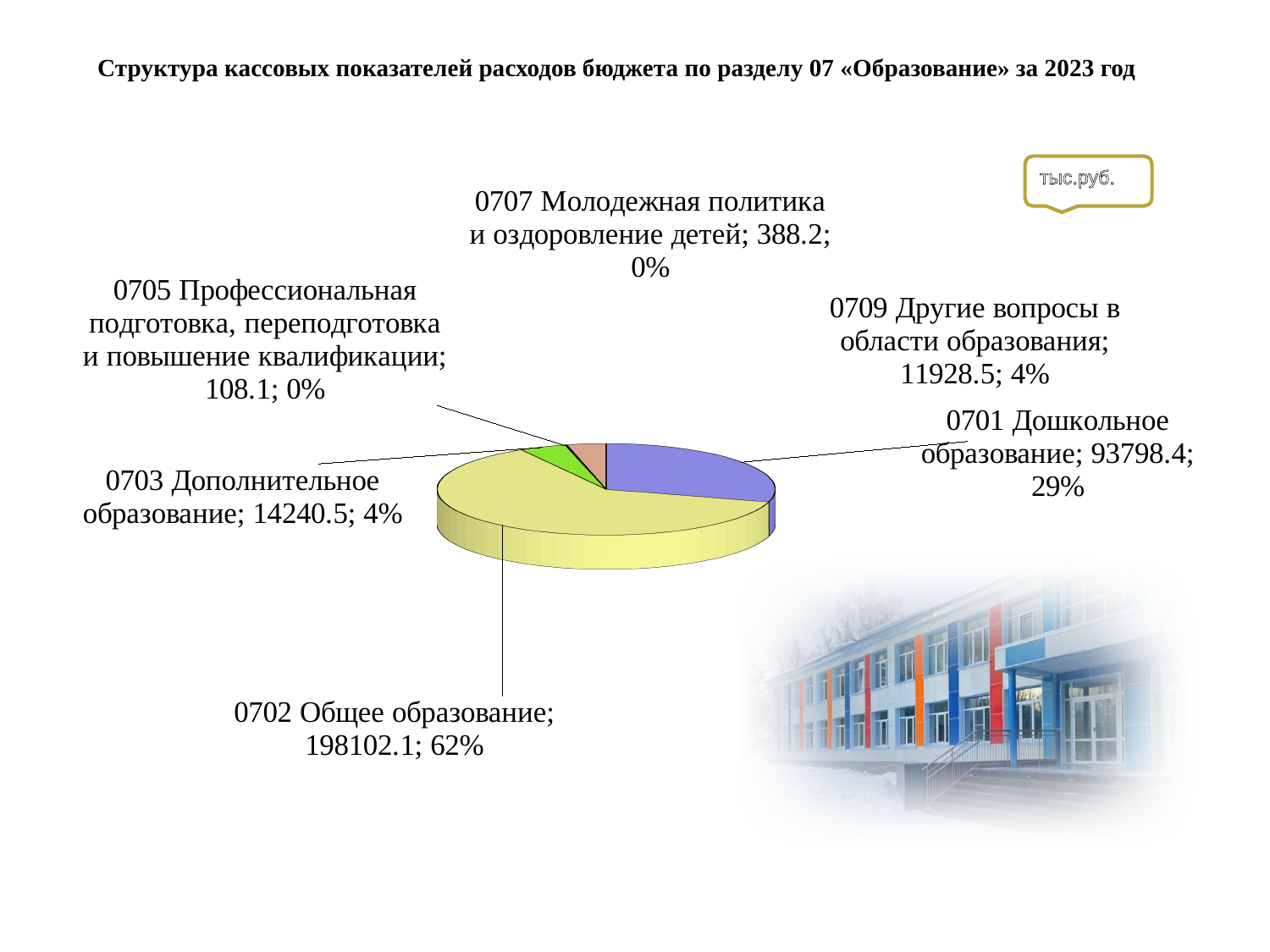
What is the value for 0707 Молодежная политика и оздоровление детей? 388.2 Which category has the largest value? 0702 Общее образование Which is larger, the value for 0703 Дополнительное образование or 0709 Другие вопросы в области образования? 0703 Дополнительное образование What kind of chart is shown on the slide? Pie chart How many categories are shown in the chart? 6 What is the difference between the values for 0702 Общее образование and 0701 Дошкольное образование? 104303.7 What is the value for 0701 Дошкольное образование? 93798.4 Which category has the smallest value? 0705 Профессиональная подготовка, переподготовка и повышение квалификации What is the value for 0702 Общее образование? 198102.1 What share of the pie does 0702 Общее образование represent? 62% What share of the pie does 0701 Дошкольное образование represent? 29% What is the value for 0709 Другие вопросы в области образования? 11928.5